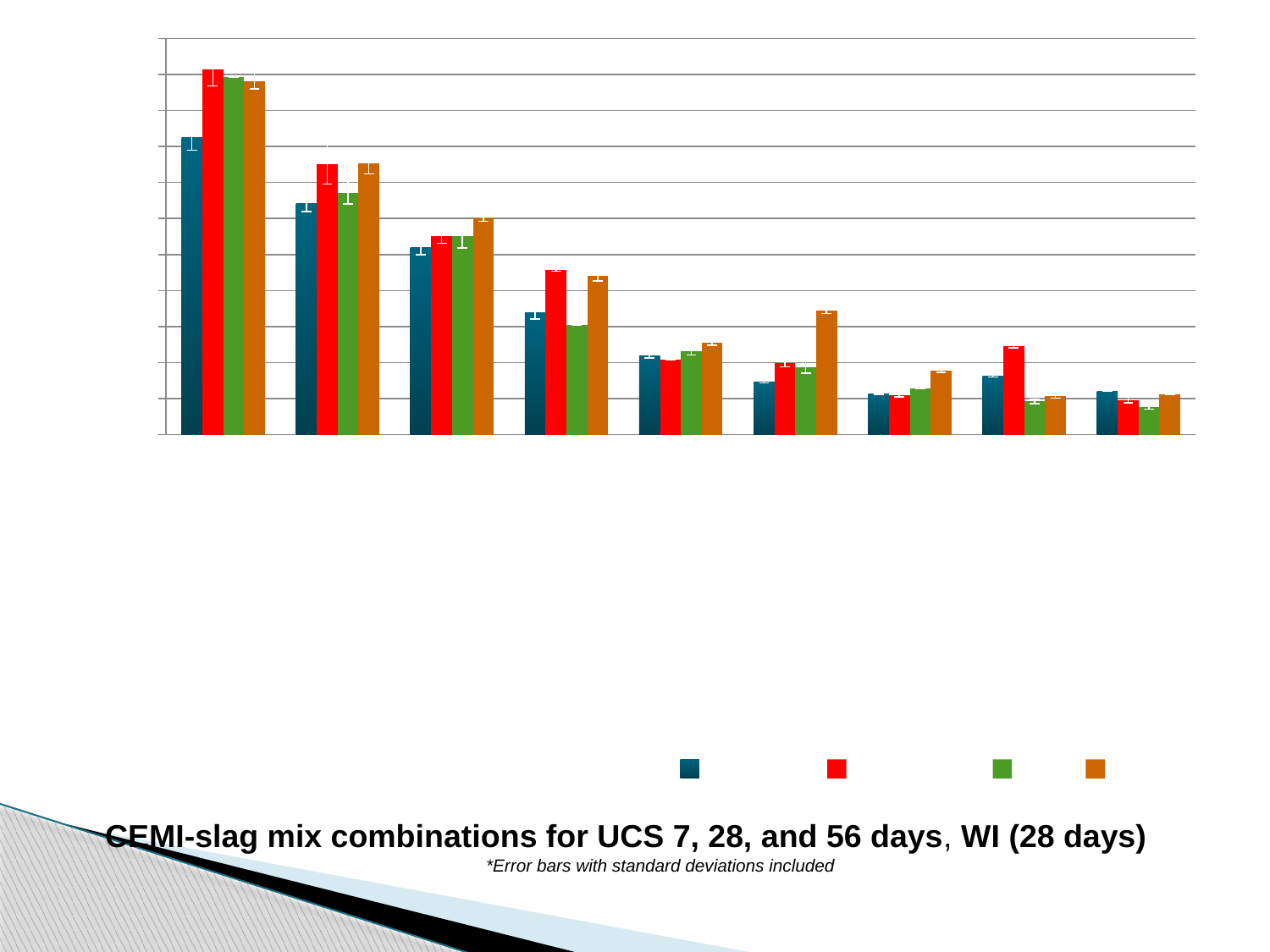
In the fourth group of bars from the left, is the red bar taller or shorter than the green bar? taller In the leftmost group of bars, which coloured bar is the tallest? the red bar How many series does the legend show? 4 Do the bar heights generally rise or fall moving from left to right along the x axis? fall In the eighth group of bars from the left, which coloured bar is the tallest? the red bar In the sixth group of bars from the left, which coloured bar is the tallest? the orange bar What is the title text shown below the chart? CEMI-slag mix combinations for UCS 7, 28, and 56 days, WI (28 days) In the leftmost group of bars, which coloured bar is the lowest? the dark teal (first) bar How many groups of bars (categories) are plotted along the x axis? 9 According to the note under the title, what do the error bars represent? standard deviations What kind of chart is shown on the slide? bar chart